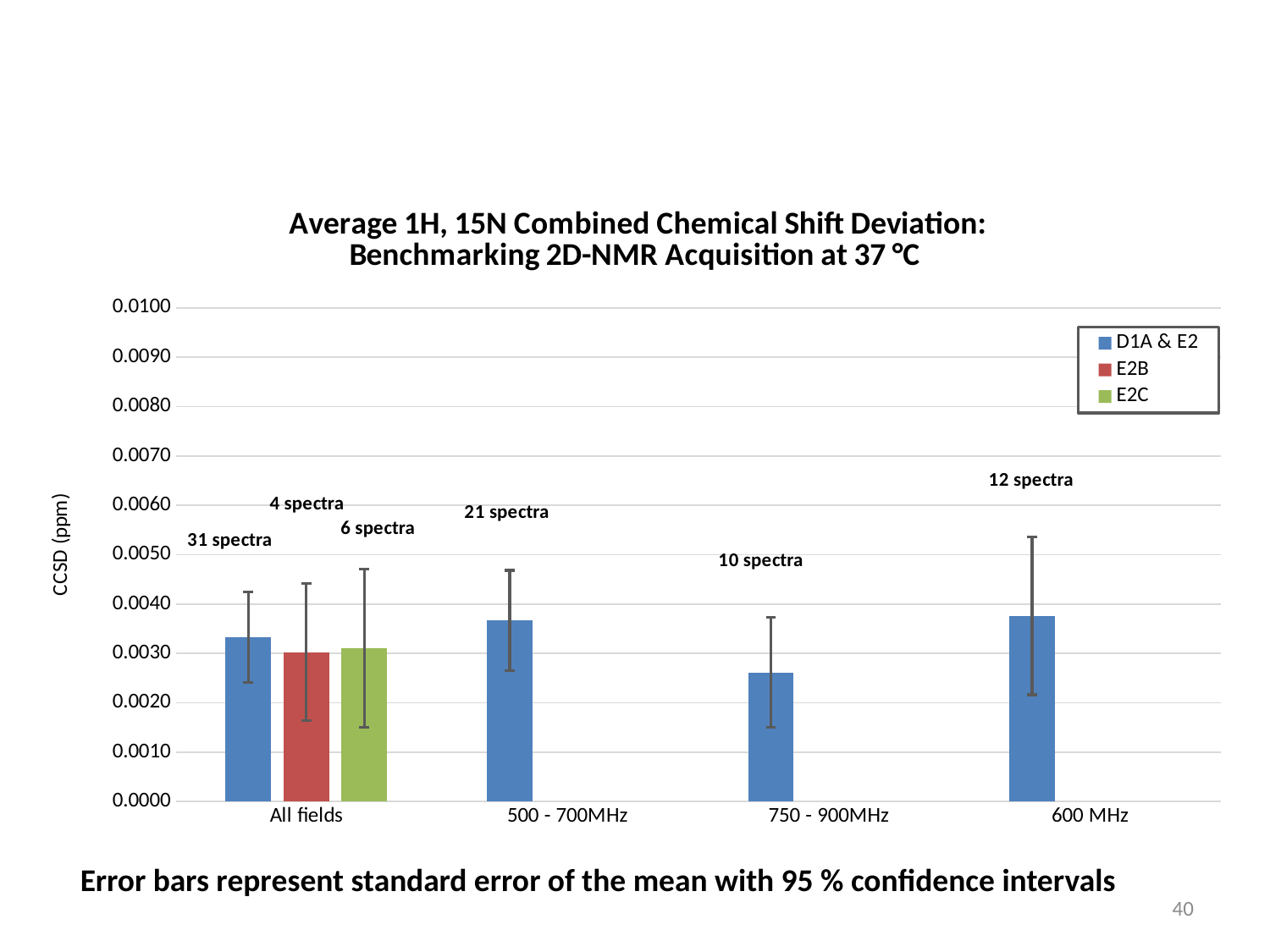
How many spectra are indicated above the 750 - 900MHz bar? 10 spectra Among the D1A & E2 bars, which category has the lowest value? 750 - 900MHz Which series is plotted in red? E2B Is the D1A & E2 value for 750 - 900MHz greater or less than 0.0030? less Is the D1A & E2 value for 600 MHz greater or less than 0.0030? greater What is the label on the y axis? CCSD (ppm) How many series does the legend list? 3 How many categories are shown on the x axis? 4 Which is larger, the D1A & E2 value for 500 - 700MHz or for 750 - 900MHz? 500 - 700MHz How many spectra are indicated for the E2C bar in the All fields category? 6 spectra How many spectra are indicated above the 600 MHz bar? 12 spectra What kind of chart is shown on the slide? bar chart